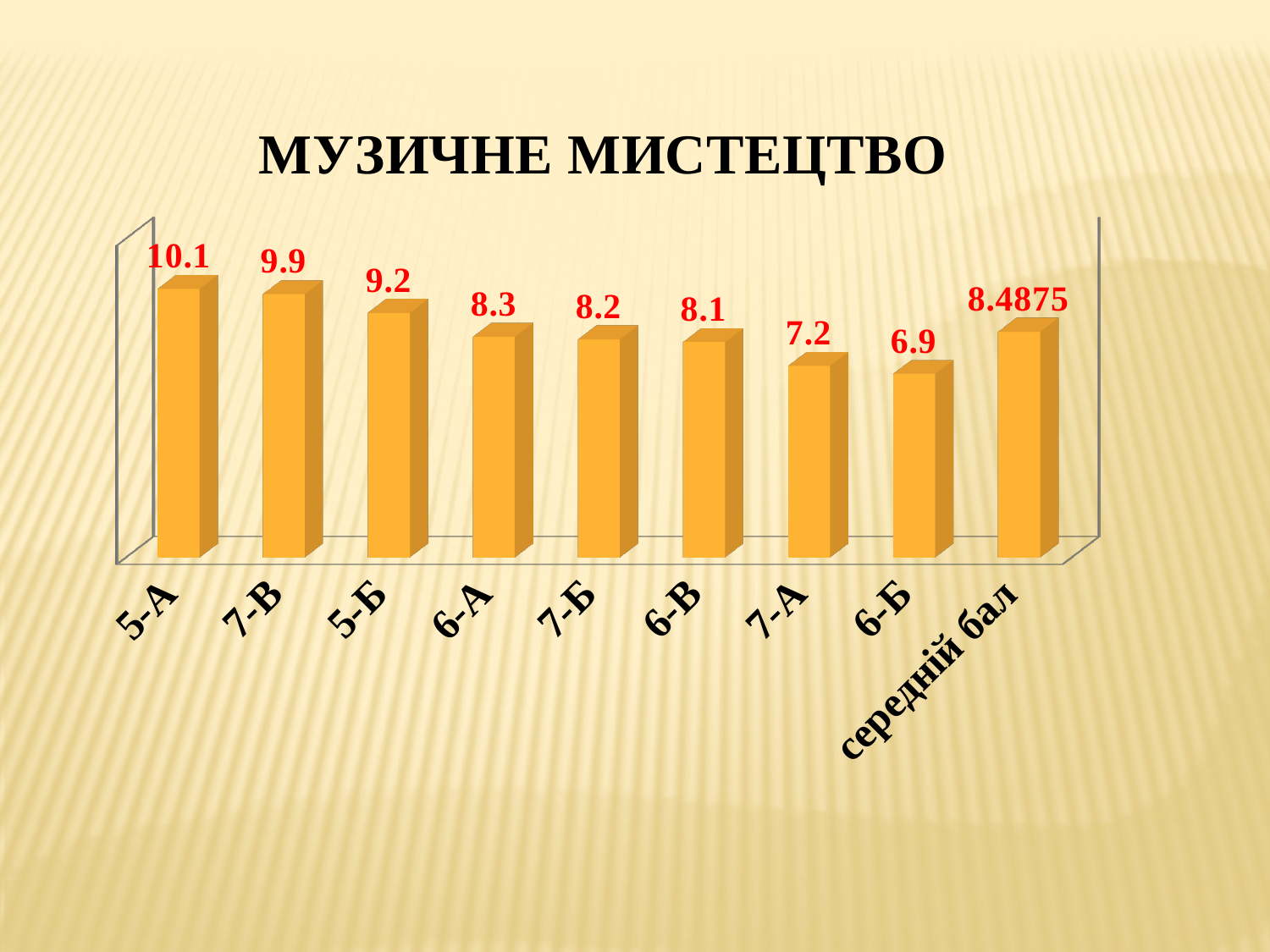
What is the title of the slide? МУЗИЧНЕ МИСТЕЦТВО Which category has the highest value? 5-А How many categories are shown on the x axis? 9 Which is larger, the value for 6-А or the value for 7-А? 6-А What is the value for 5-А? 10.1 What is the difference between the values for 7-В and 5-Б? 0.7 What kind of chart is shown on the slide? bar chart What is the value for 7-А? 7.2 What is the difference between the values for 5-А and 6-Б? 3.2 What is the value for 6-Б? 6.9 Which category has the lowest value? 6-Б What is the value for середній бал? 8.4875